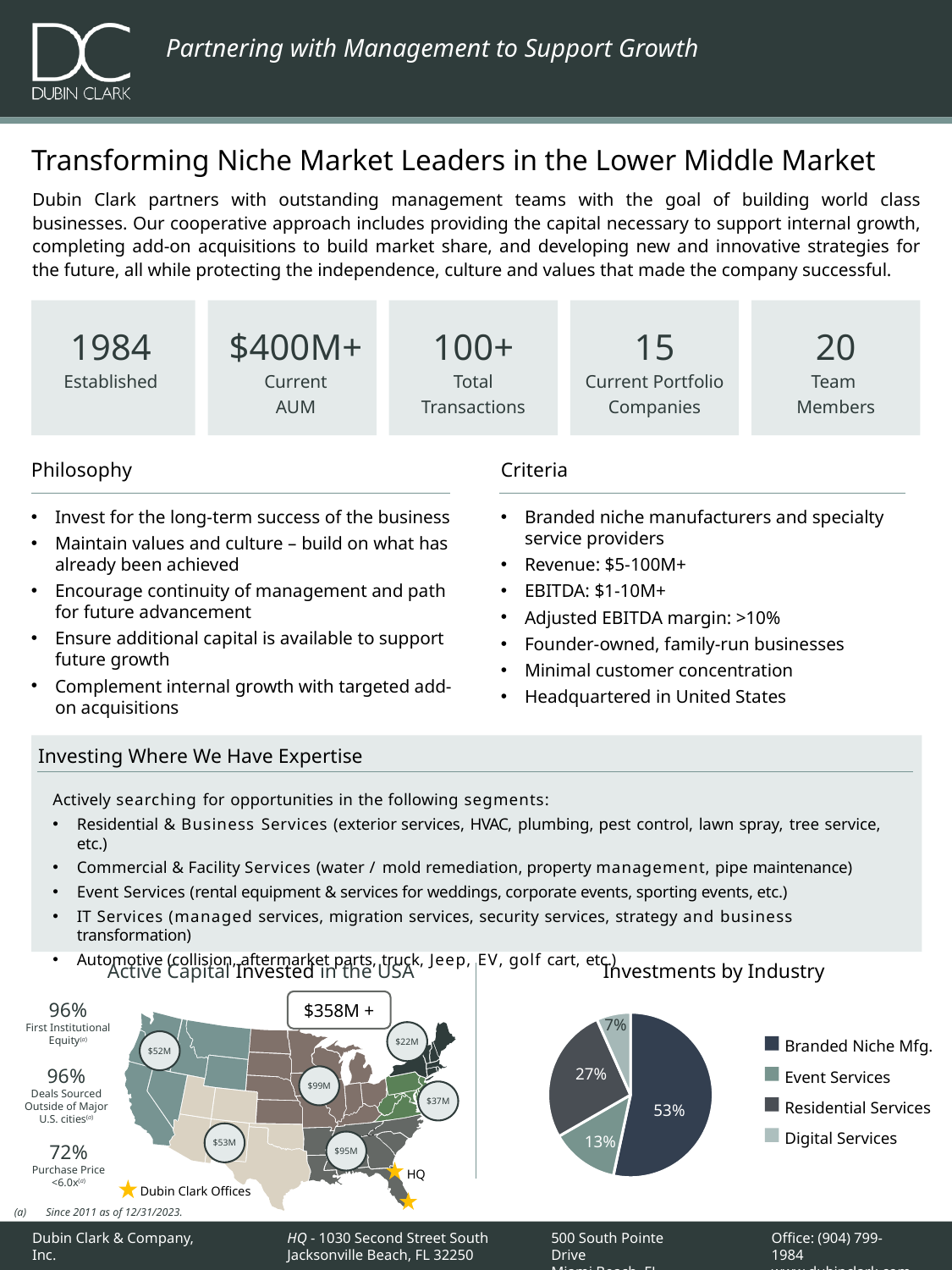
In the Investments by Industry chart, which industry has the largest share? Branded Niche Mfg. In the Investments by Industry chart, which industry has the smallest share? Digital Services In the Investments by Industry chart, what share of investments is Digital Services? 7% In the Investments by Industry chart, what is the difference in percentage points between Branded Niche Mfg. and Residential Services? 26 percentage points In the Investments by Industry chart, how many industries are shown? 4 In the Investments by Industry chart, what share of investments is Event Services? 13% What is the title of the pie chart on the slide? Investments by Industry What type of chart is the Investments by Industry chart? Pie chart In the Investments by Industry chart, which is larger: Event Services or Residential Services? Residential Services In the Investments by Industry chart, what share of investments is Residential Services? 27% In the Investments by Industry chart, what is the combined share of Event Services and Digital Services? 20% In the Investments by Industry chart, what share of investments is Branded Niche Mfg.? 53%